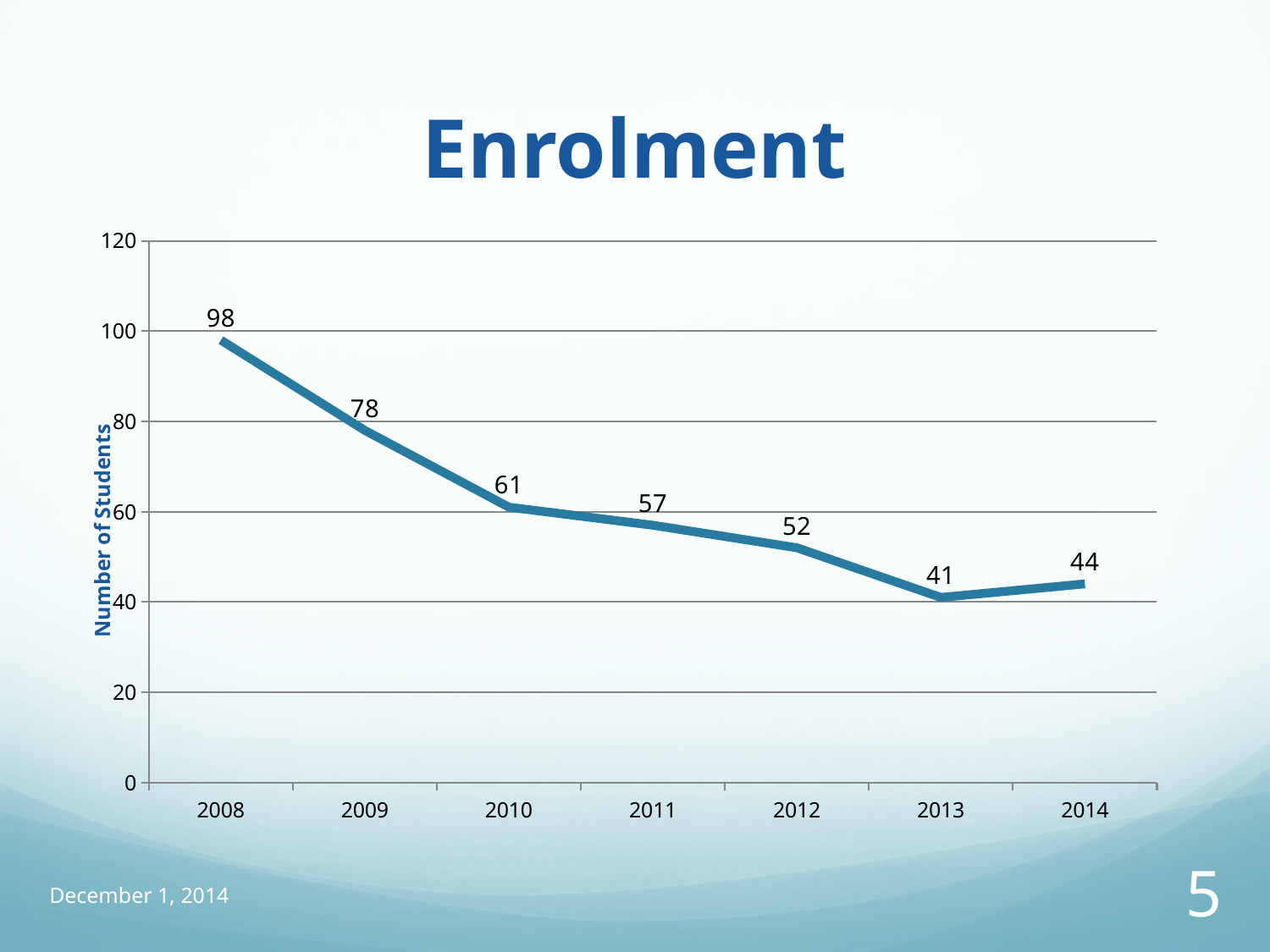
By how much did enrolment fall from 2008 to 2009? 20 Which year had the highest enrolment? 2008 What was the enrolment in 2008? 98 What was the enrolment in 2014? 44 Which year had more students, 2010 or 2012? 2010 What is the difference in enrolment between 2012 and 2013? 11 What is the label of the vertical axis? Number of Students What was the number of students in 2011? 57 How many years are plotted on the chart? 7 Which year had the lowest enrolment? 2013 What type of chart is shown on the slide? line chart Is the enrolment in 2009 greater or less than 80? less